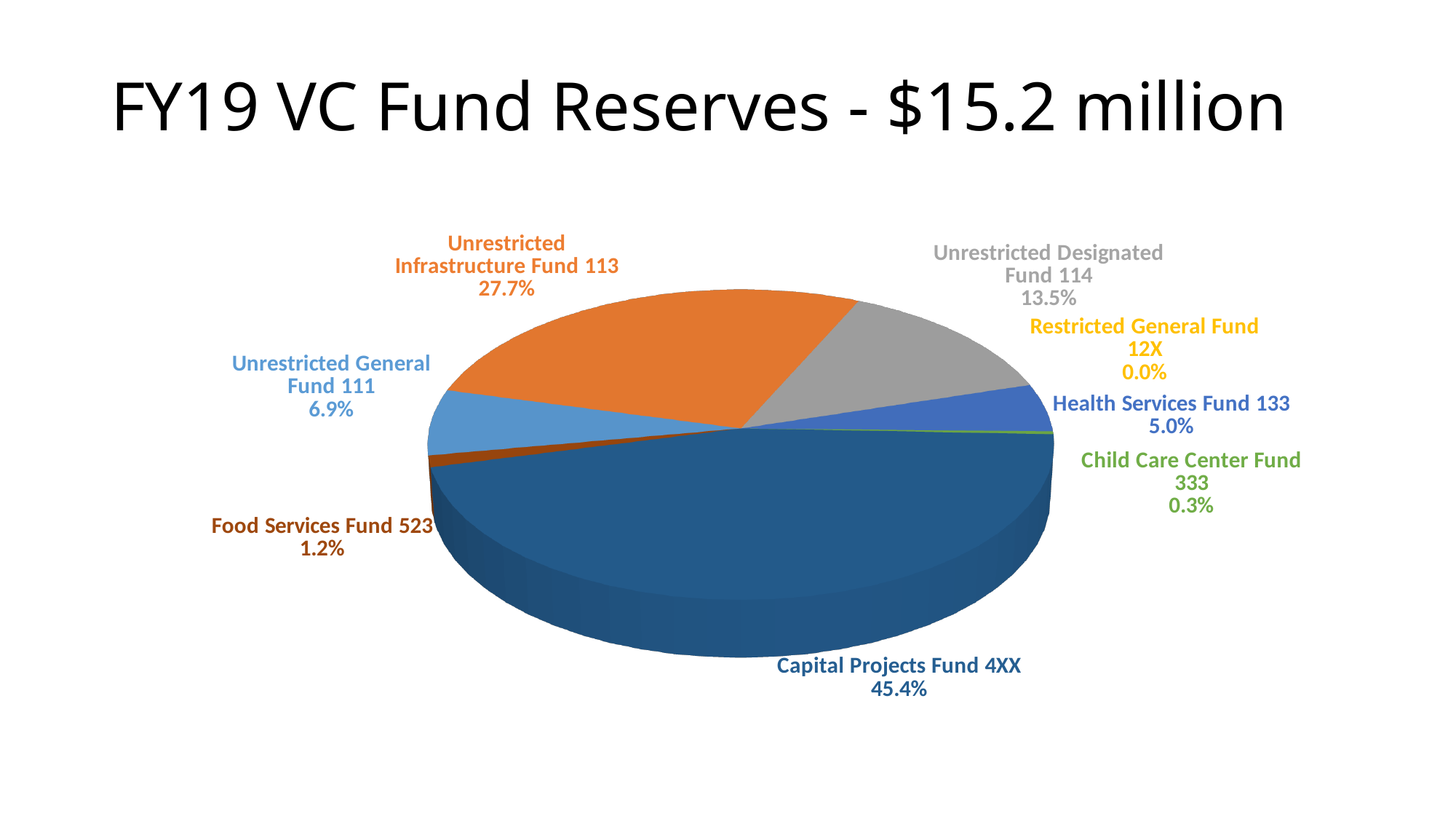
What is the title of the slide? FY19 VC Fund Reserves - $15.2 million What percentage is shown for Health Services Fund 133? 5.0% What kind of chart is shown on the slide? Pie chart What share of the pie does Capital Projects Fund 4XX hold? 45.4% What percentage is shown for Unrestricted Designated Fund 114? 13.5% How many fund categories are labelled on the pie chart? 8 Which fund has the largest share of the pie? Capital Projects Fund 4XX Which has a larger share, Unrestricted General Fund 111 or Health Services Fund 133? Unrestricted General Fund 111 Which fund has the smallest share of the pie? Restricted General Fund 12X What percentage is shown for Unrestricted Infrastructure Fund 113? 27.7% What percentage is shown for Food Services Fund 523? 1.2% What is the difference in percentage points between Unrestricted Infrastructure Fund 113 and Unrestricted Designated Fund 114? 14.2